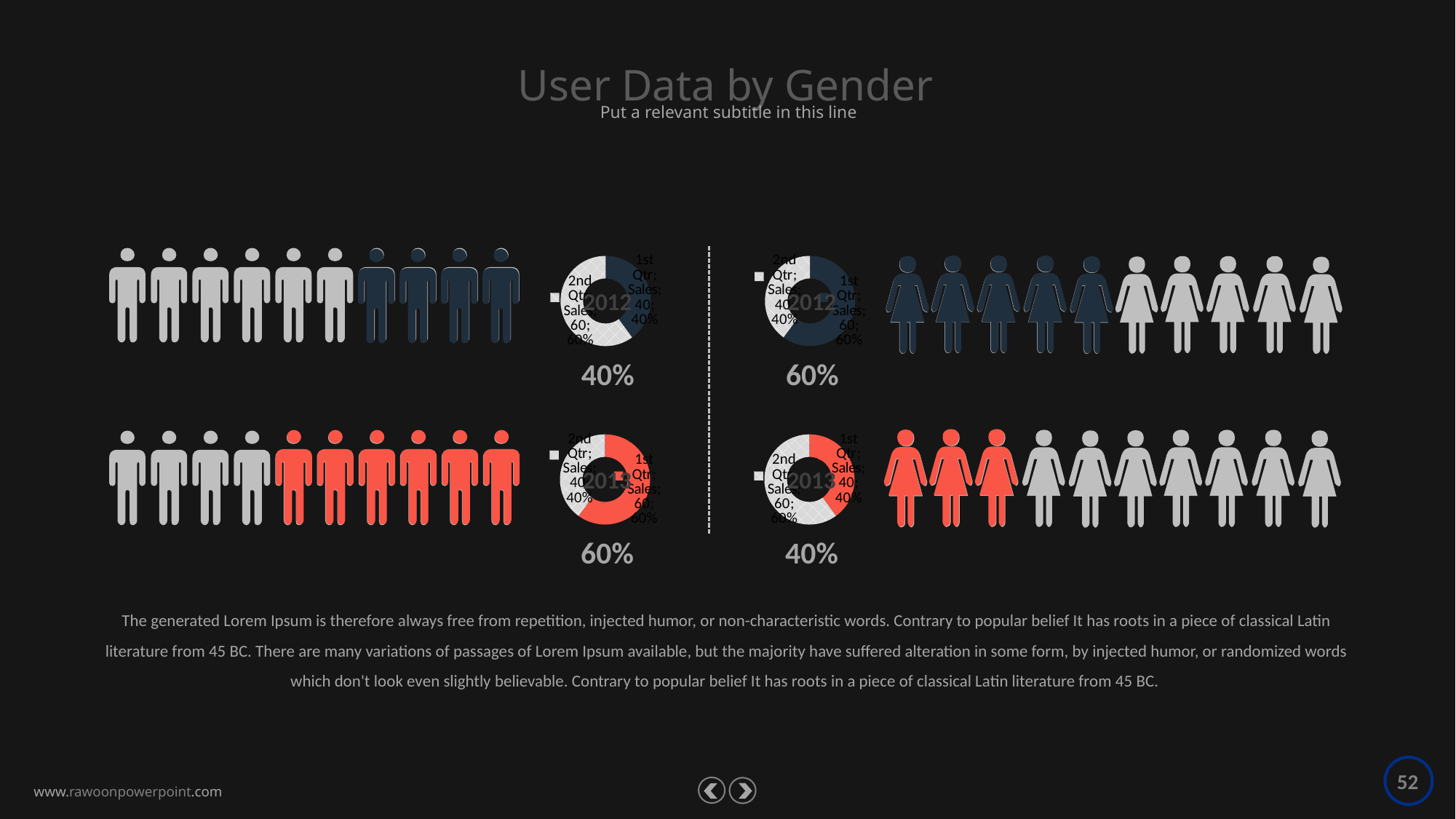
In the top-right 2012 chart, what percentage share does 2nd Qtr Sales have? 40% In the bottom-right 2013 chart, what percentage share does 1st Qtr Sales have? 40% In the top-left 2012 chart, what value is shown for 1st Qtr Sales? 40 In the top-right 2012 chart, what value is shown for 1st Qtr Sales? 60 What large percentage is printed below the top-right 2012 chart? 60% What is the title of the slide containing these charts? User Data by Gender How many slices does the top-left 2012 chart have? 2 In the bottom-right 2013 chart, what is the difference between 2nd Qtr Sales and 1st Qtr Sales? 20 In the bottom-left 2013 chart, which slice is larger, 1st Qtr or 2nd Qtr? 1st Qtr What kind of chart is the top-left chart labelled 2012? Doughnut (pie) chart In the top-left 2012 chart, what percentage share does 2nd Qtr Sales have? 60% In the bottom-left 2013 chart, what value is shown for 2nd Qtr Sales? 40